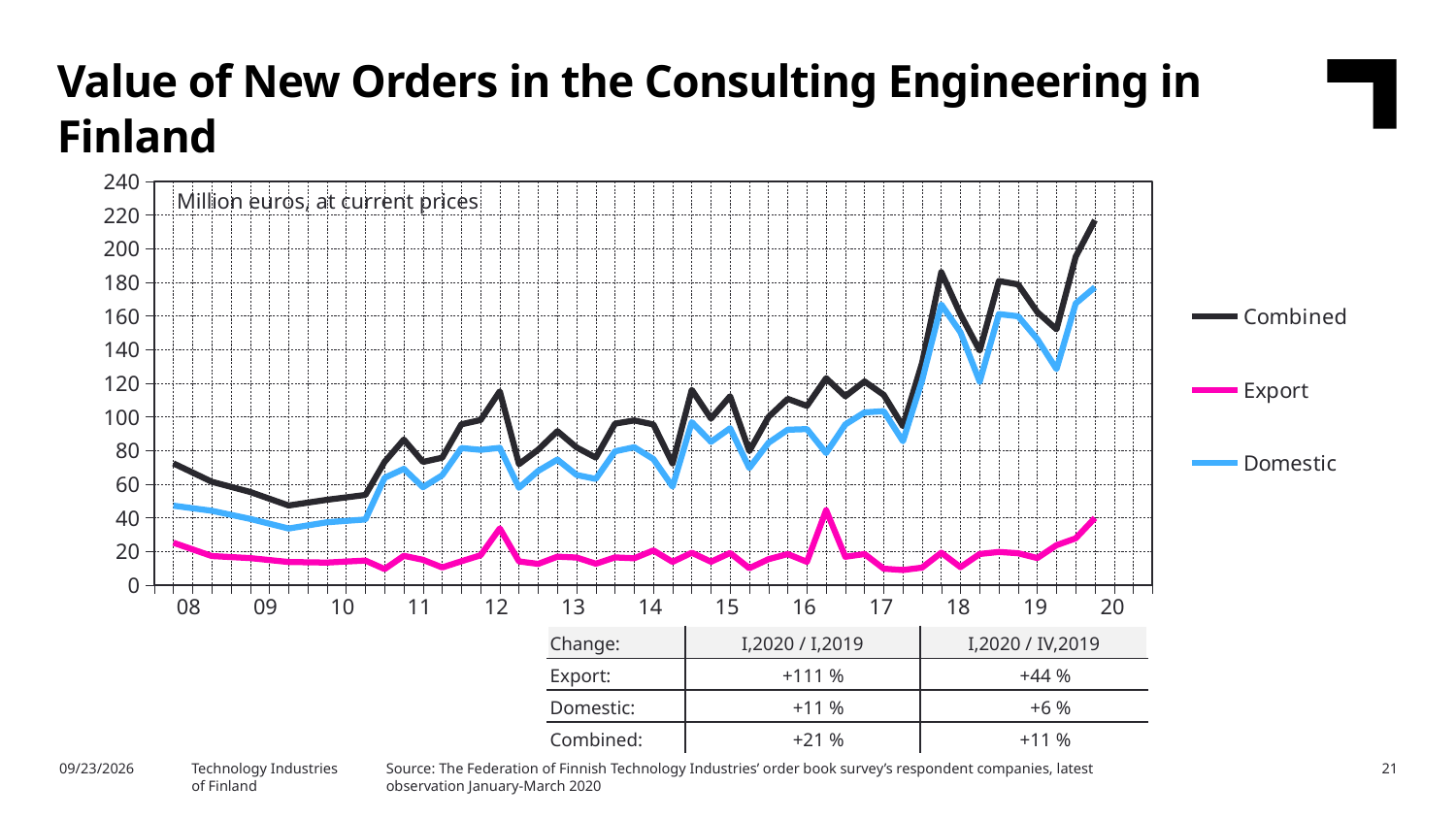
What kind of chart is shown on the slide? line chart Is the value of the Domestic series at its final point in 2020 greater or less than 160? greater Which series is larger at the final point in 2020, Domestic or Export? Domestic How many series does the chart legend list? 3 Is the highest value reached by the Export series greater or less than 60? less Which series has the lowest values throughout the chart? Export What are the three series named in the chart legend? Combined, Export, Domestic What unit is stated in the label inside the chart area? Million euros, at current prices Is the value of the Combined series at its final point in 2020 greater or less than 200? greater Which series has the highest values throughout the chart? Combined Does the Combined series rise or fall overall between 2017 and 2020? rise